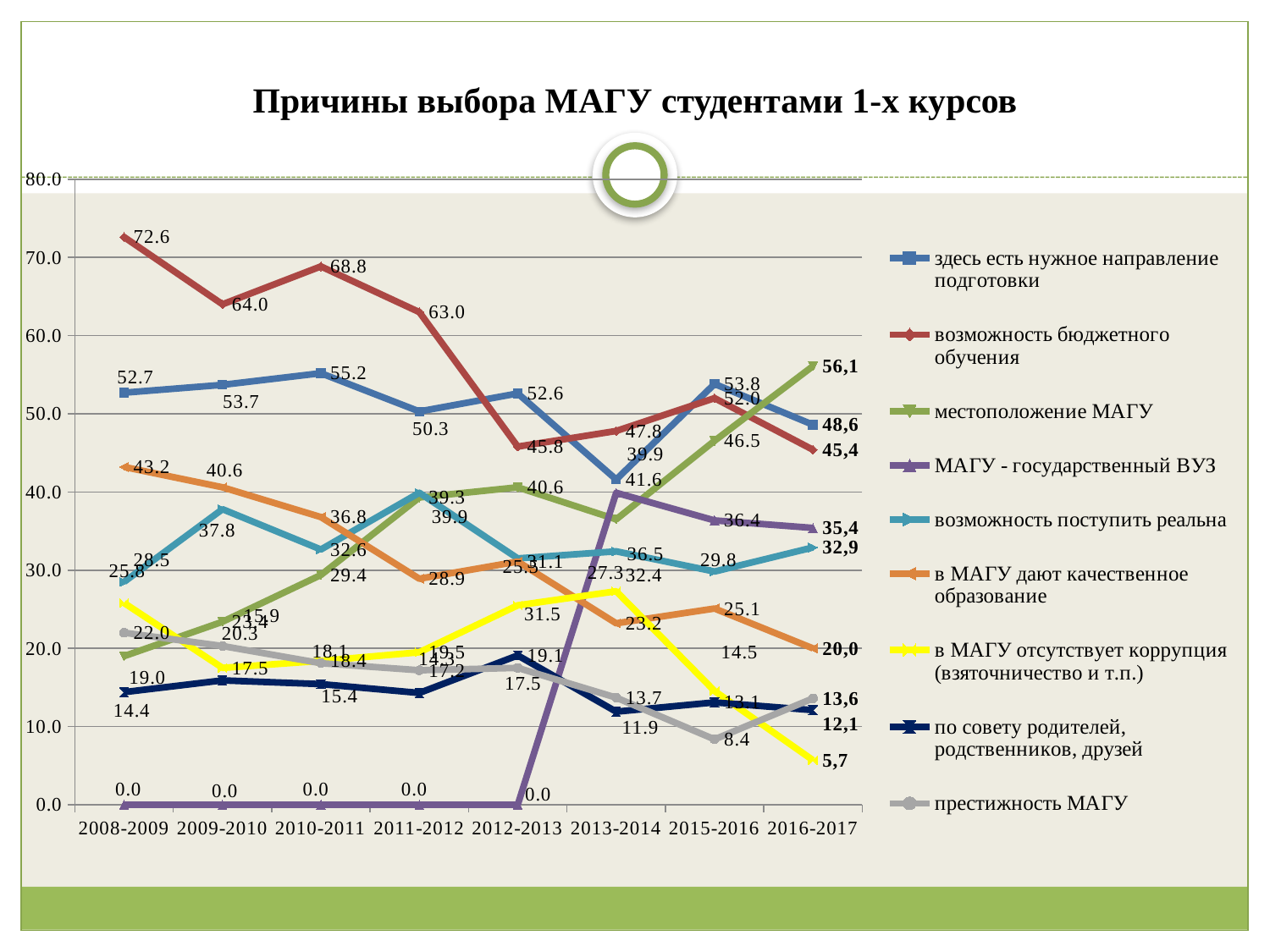
Which series has the highest value in 2016-2017? местоположение МАГУ How many series does the legend list? 9 What is the value for 'МАГУ - государственный ВУЗ' in 2012-2013? 0.0 What is the difference between the 2008-2009 and 2009-2010 values for 'возможность бюджетного обучения'? 8.6 What kind of chart is shown on the slide? line chart What is the value for 'здесь есть нужное направление подготовки' in 2016-2017? 48,6 What is the value for 'возможность бюджетного обучения' in 2008-2009? 72.6 Which series has the lowest value in 2016-2017? в МАГУ отсутствует коррупция (взяточничество и т.п.) In which year does 'возможность бюджетного обучения' reach its highest value? 2008-2009 In 2013-2014, which is larger: 'возможность бюджетного обучения' or 'здесь есть нужное направление подготовки'? возможность бюджетного обучения What is the value for 'престижность МАГУ' in 2015-2016? 8.4 How many academic-year categories are shown on the x axis? 8